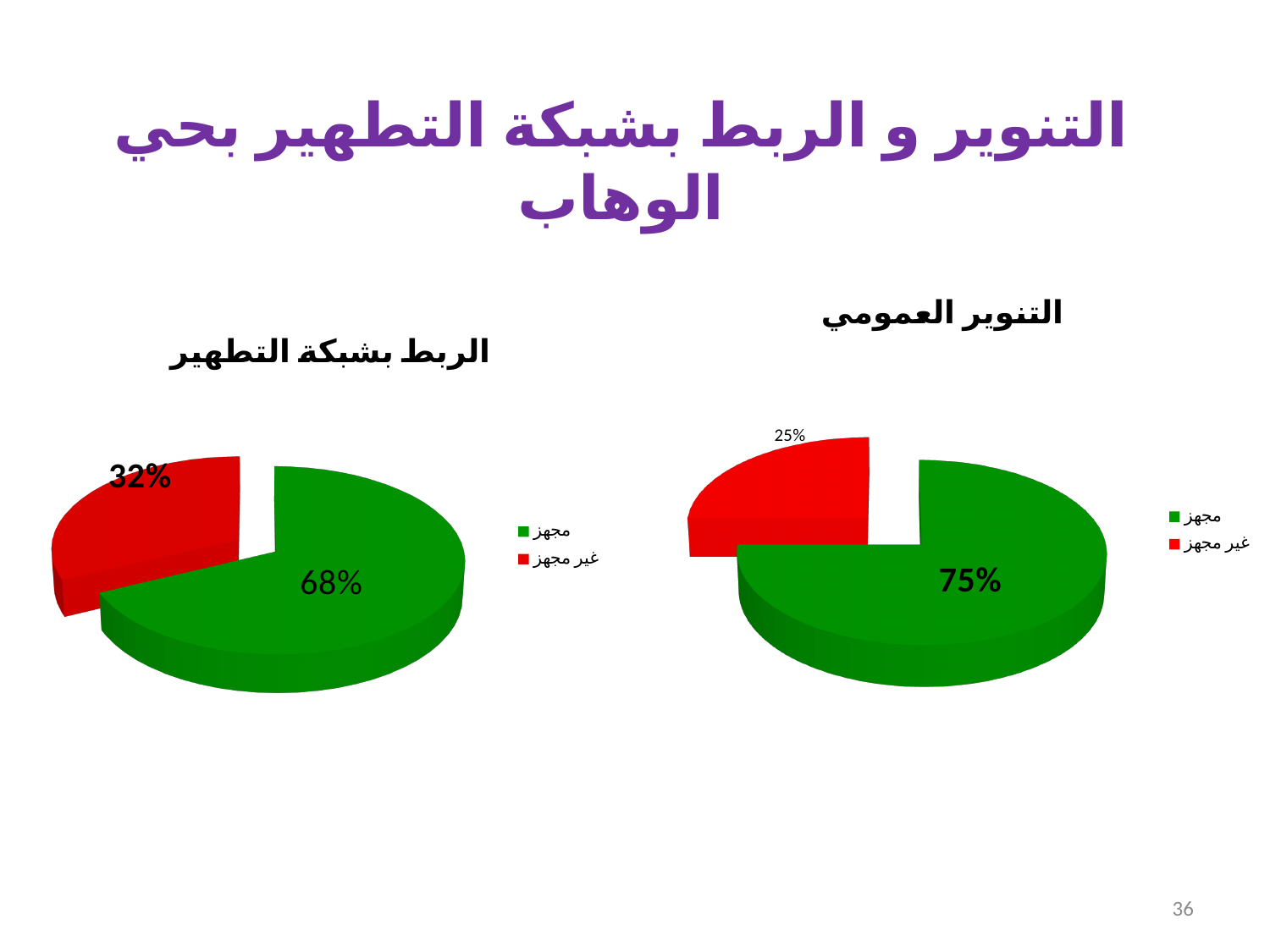
What type of chart is the chart titled "التنوير العمومي"? Pie chart In the chart titled "الربط بشبكة التطهير", what is the value for "مجهز"? 68% In the chart titled "التنوير العمومي", what is the difference between the "مجهز" and "غير مجهز" slices? 50% In the chart titled "التنوير العمومي", which category has the smallest slice? غير مجهز How many categories does the chart titled "الربط بشبكة التطهير" show? 2 In the chart titled "التنوير العمومي", what is the value for "مجهز"? 75% In the chart titled "الربط بشبكة التطهير", what is the value for "غير مجهز"? 32% In the chart titled "الربط بشبكة التطهير", which category has the largest slice? مجهز Which is larger: the "مجهز" share in the chart titled "التنوير العمومي" or the "مجهز" share in the chart titled "الربط بشبكة التطهير"? التنوير العمومي In the chart titled "الربط بشبكة التطهير", what is the difference between the "مجهز" and "غير مجهز" slices? 36% In the chart titled "الربط بشبكة التطهير", what colour is the "غير مجهز" slice? Red In the chart titled "التنوير العمومي", what is the value for "غير مجهز"? 25%